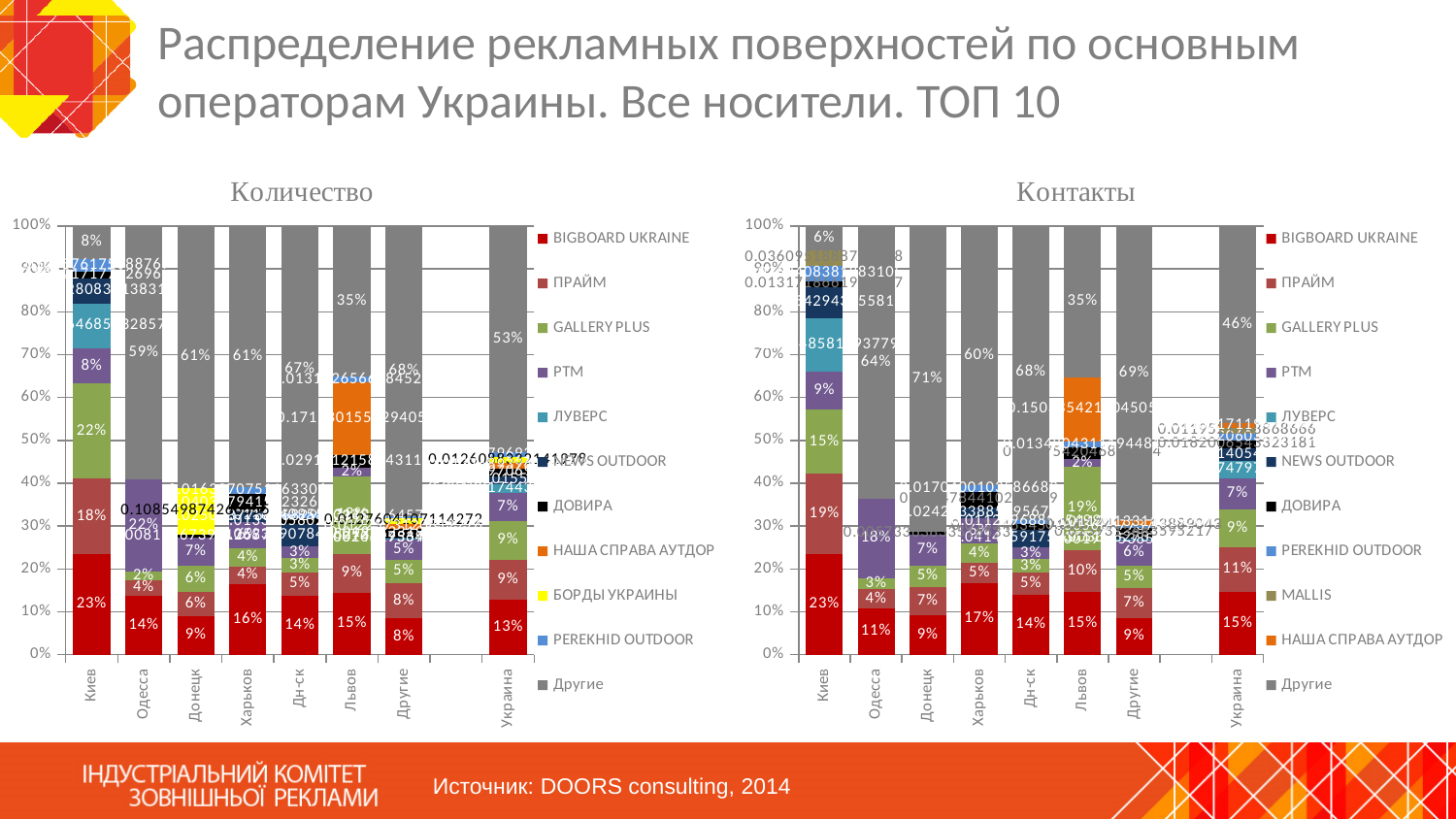
In the "Количество" chart, which category has the smallest share for Другие? Киев What source is cited for the data on the slide? DOORS consulting, 2014 How many categories (cities/regions) are shown on the x axis of the "Количество" chart? 8 In the "Контакты" chart, what is the share of Другие for Украина? 46% In the "Количество" chart, what is the share of BIGBOARD UKRAINE for Киев? 23% In the "Контакты" chart, what is the share of ПРАЙМ for Киев? 19% What kind of chart is the "Количество" chart on the left? Stacked bar chart In the "Количество" chart, what is the share of Другие for Львов? 35% In the "Количество" chart, what is the difference between the GALLERY PLUS share (22%) and the ПРАЙМ share (18%) for Киев? 4 percentage points In the "Количество" chart, what is the share of BIGBOARD UKRAINE for Украина? 13% In the "Контакты" chart, which has the larger BIGBOARD UKRAINE share: Харьков or Одесса? Харьков How many series does the legend of the "Количество" chart list? 11